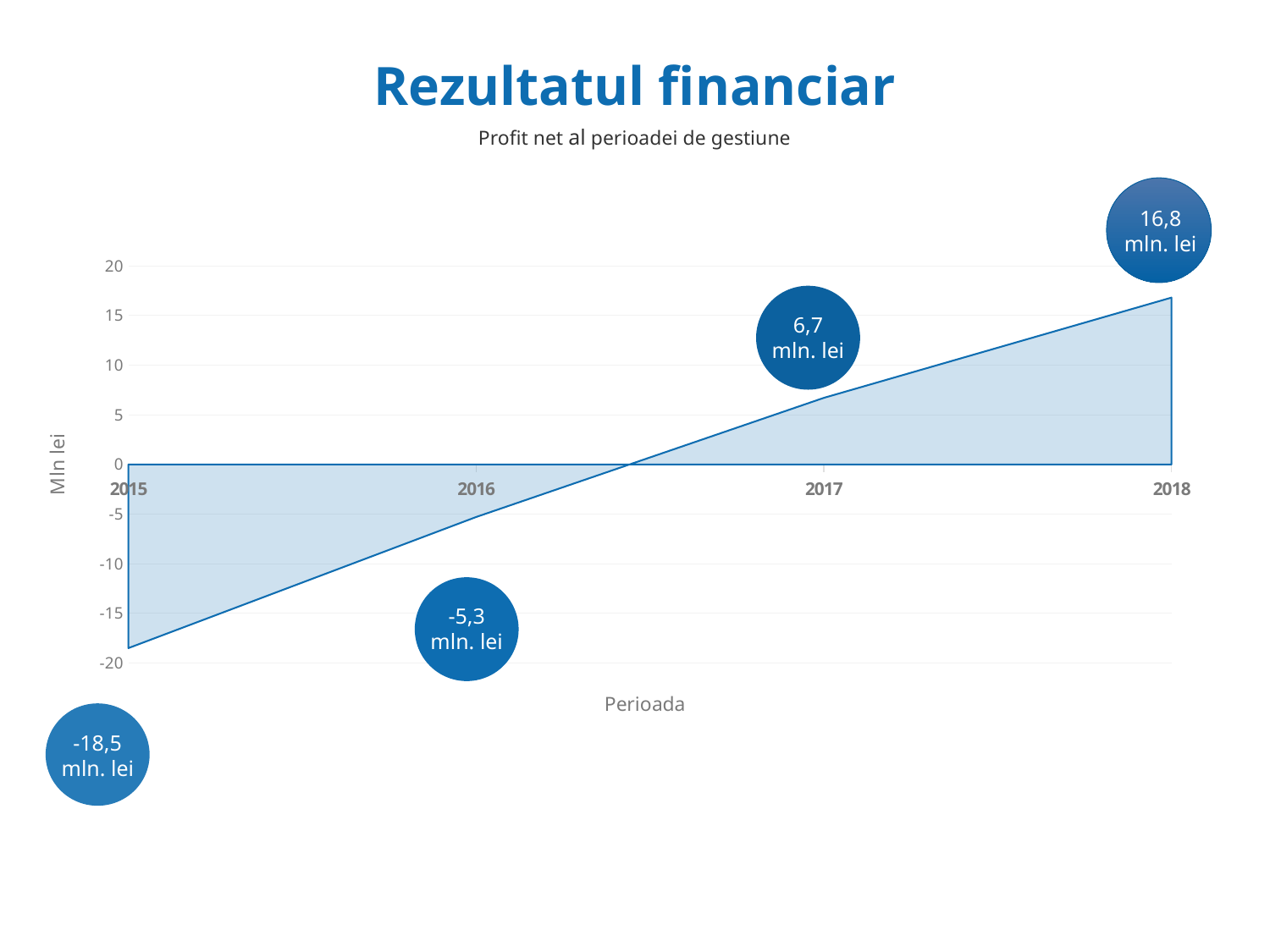
How many years are plotted on the chart? 4 What is the net profit value shown for 2015? -18,5 mln. lei What is the net profit value shown for 2016? -5,3 mln. lei What is the title of the chart? Profit net al perioadei de gestiune What is the net profit value shown for 2017? 6,7 mln. lei Which year has the lowest net profit? 2015 What is the difference between the net profit in 2016 and in 2015? 13,2 mln. lei What is the net profit value shown for 2018? 16,8 mln. lei Which year has the highest net profit? 2018 Which year has a larger net profit, 2016 or 2017? 2017 Does the net profit rise or fall from 2015 to 2018? Rise By how much did the net profit increase from 2017 to 2018? 10,1 mln. lei